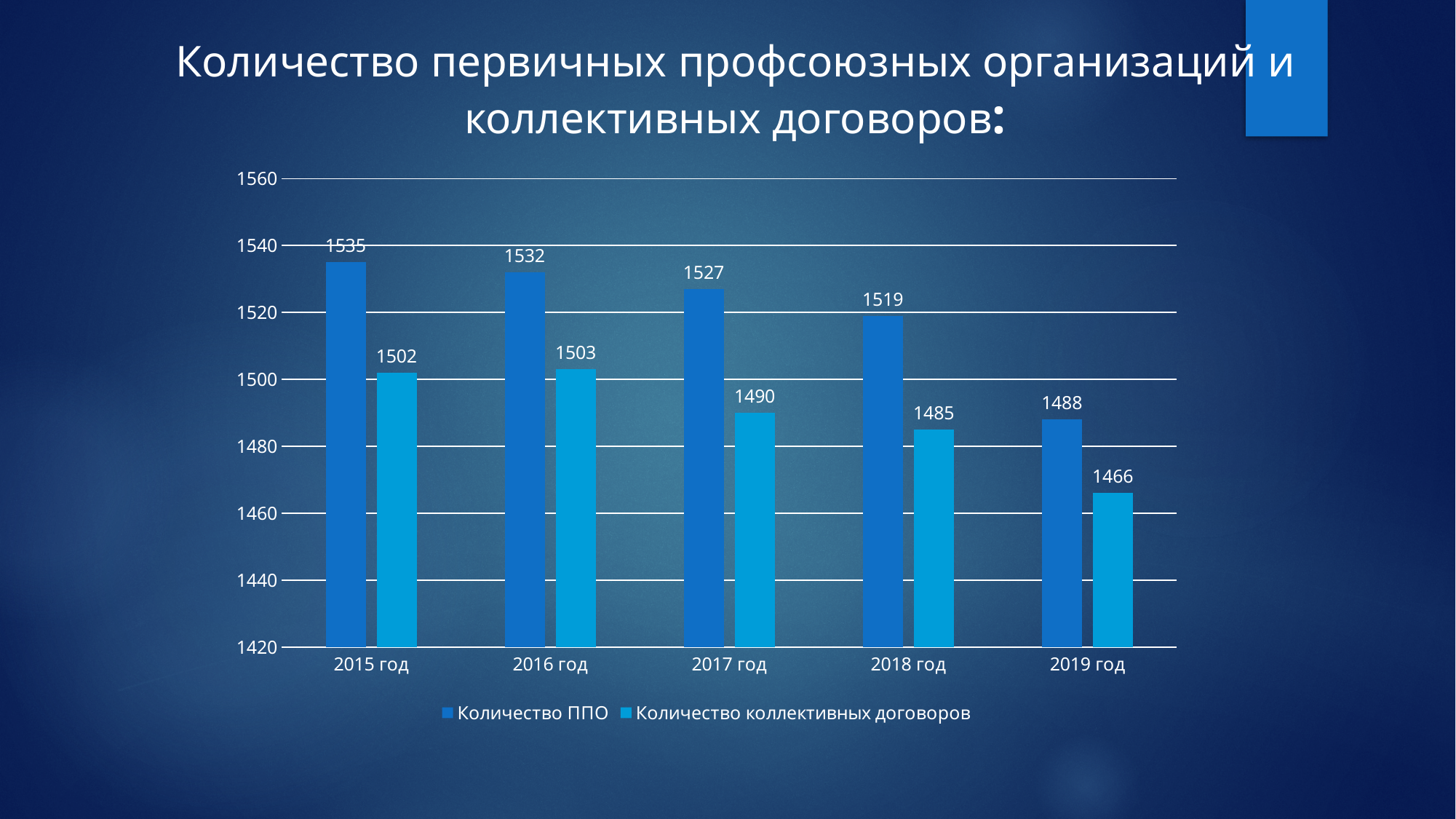
What is the value of Количество коллективных договоров for 2019 год? 1466 Which is larger in 2016 год: Количество ППО or Количество коллективных договоров? Количество ППО What is the value of Количество ППО for 2015 год? 1535 Do the values for Количество ППО rise or fall from 2015 год to 2019 год? Fall Which year has the highest value for Количество ППО? 2015 год How many series does the legend list? 2 What is the difference between Количество ППО and Количество коллективных договоров in 2018 год? 34 What is the value of Количество коллективных договоров for 2017 год? 1490 Which year has the lowest value for Количество коллективных договоров? 2019 год How many years are shown on the x axis? 5 What kind of chart is shown on the slide? Bar chart By how much did Количество ППО decrease from 2015 год to 2019 год? 47